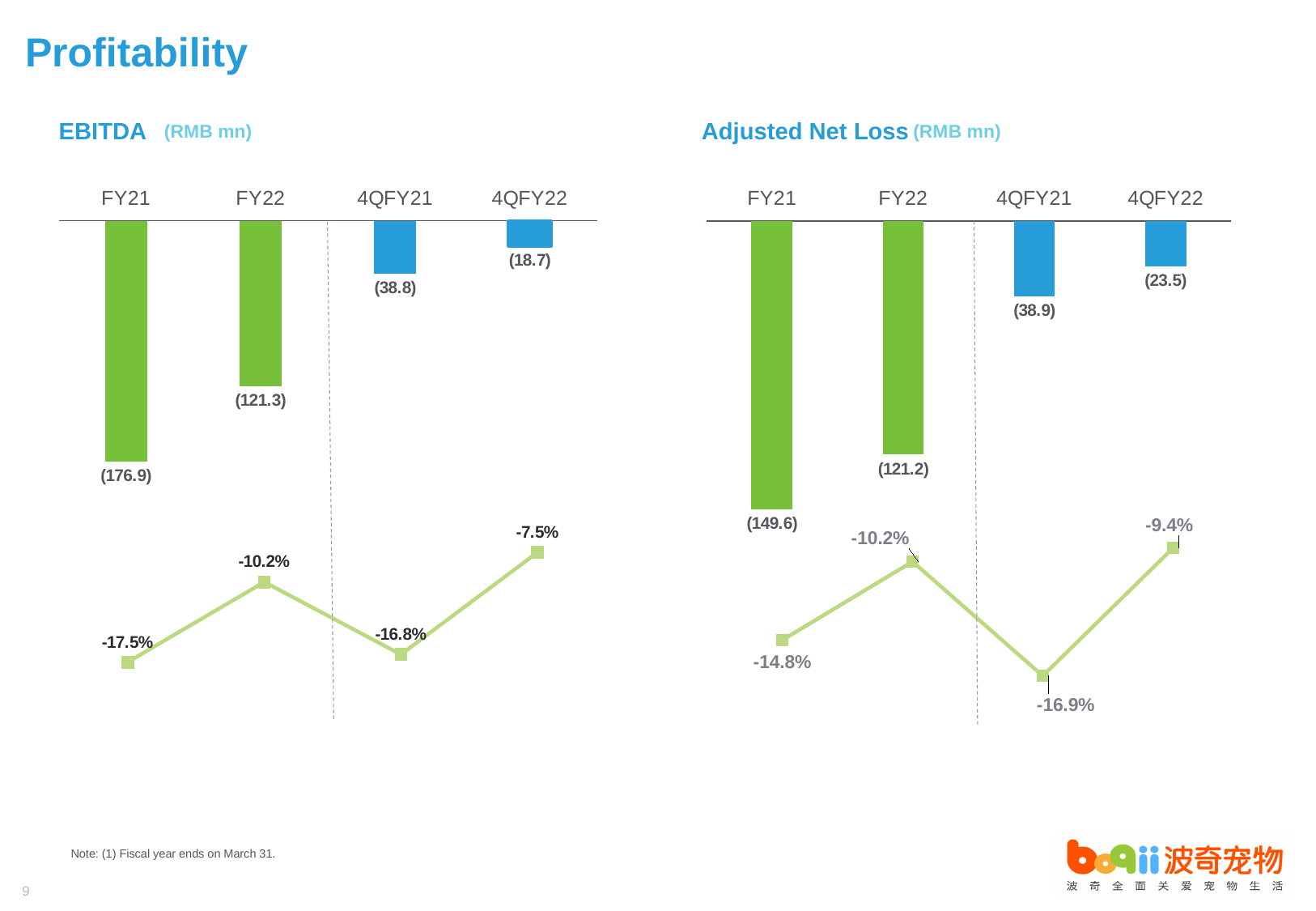
In the Adjusted Net Loss chart, what percentage is labelled at the 4QFY21 point on the line? -16.9% What unit is stated next to the EBITDA chart title? RMB mn In the EBITDA chart, what is the value shown for 4QFY22? (18.7) In the EBITDA chart, which period has the smallest bar? 4QFY22 In the Adjusted Net Loss chart, what is the value shown for FY22? (121.2) In the EBITDA chart, what is the value shown for FY21? (176.9) In the EBITDA chart, what percentage is labelled at the FY22 point on the line? -10.2% In the EBITDA chart, what is the difference between the FY21 value of 176.9 and the FY22 value of 121.3? 55.6 In the Adjusted Net Loss chart, what is the value shown for 4QFY21? (38.9) In the EBITDA chart, what percentage is labelled at the 4QFY22 point on the line? -7.5% In the Adjusted Net Loss chart, which period has the largest bar? FY21 How many periods are shown on the x axis of the Adjusted Net Loss chart? 4